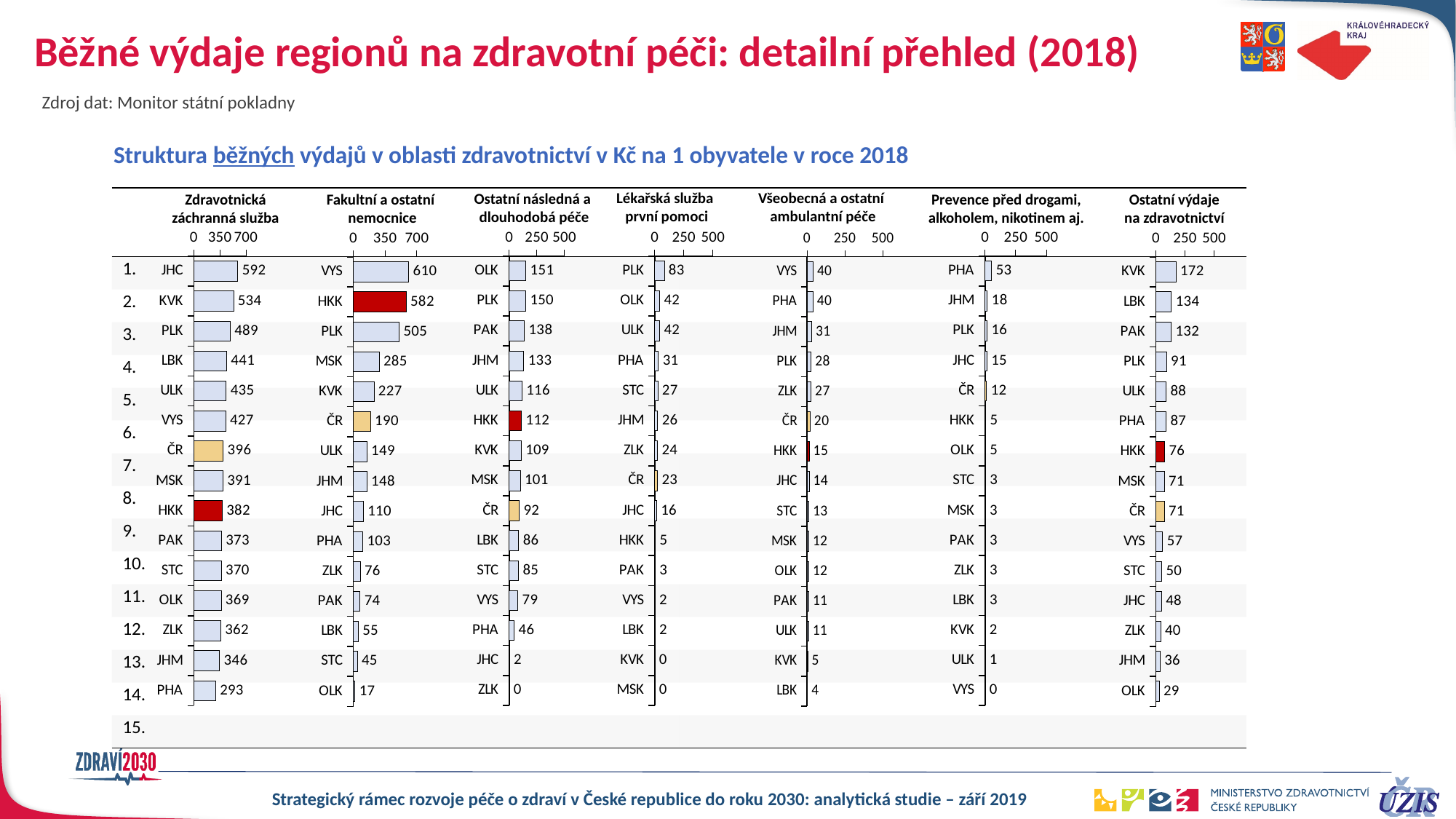
In the 'Ostatní následná a dlouhodobá péče' chart, which region has the lowest value? ZLK In the 'Lékařská služba první pomoci' chart, what is the difference between PLK and OLK? 41 In the 'Ostatní výdaje na zdravotnictví' chart, what is the value for HKK? 76 What type of chart is used for 'Fakultní a ostatní nemocnice'? Bar chart In the 'Fakultní a ostatní nemocnice' chart, what is the value for HKK? 582 In the 'Prevence před drogami, alkoholem, nikotinem aj.' chart, what is the value for PHA? 53 In the 'Fakultní a ostatní nemocnice' chart, which region has the highest value? VYS In the 'Ostatní výdaje na zdravotnictví' chart, which region has the highest value? KVK In the 'Zdravotnická záchranná služba' chart, what is the value for JHC? 592 In the 'Zdravotnická záchranná služba' chart, is the value for PHA greater or less than 350? less How many regions (bars) are shown in the 'Zdravotnická záchranná služba' chart? 15 In the 'Všeobecná a ostatní ambulantní péče' chart, which is larger, the value for JHM or the value for HKK? JHM